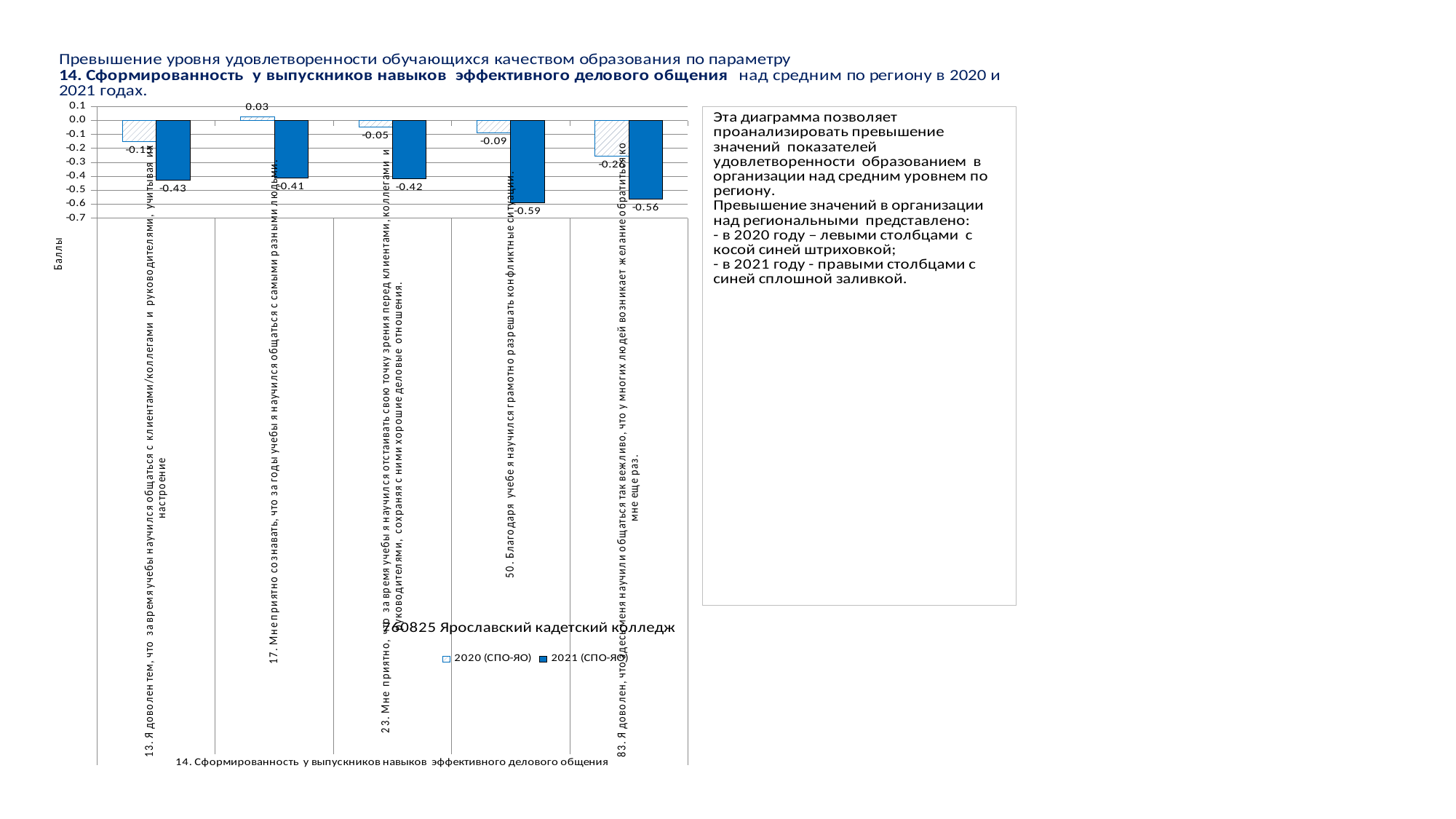
How many categories are shown on the x axis of the chart? 5 What is the 2020 (СПО-ЯО) value for category 23? -0.05 What is the 2021 (СПО-ЯО) value for category 13? -0.43 Which category has the highest 2020 (СПО-ЯО) value? 17 What is the 2020 (СПО-ЯО) value for category 17 (Мне приятно сознавать, что за годы учебы я научился общаться с самыми разными людьми)? 0.03 What kind of chart is shown on the slide? Bar chart Which category has the lowest 2021 (СПО-ЯО) value? 50 How many series does the legend list? 2 Which is larger: the 2020 (СПО-ЯО) value for category 17 or for category 50? Category 17 What is the difference between the 2021 (СПО-ЯО) values for category 17 and category 50? 0.18 Is the 2020 (СПО-ЯО) value for category 83 greater or less than -0.2? less What is the 2021 (СПО-ЯО) value for category 50 (Благодаря учебе я научился грамотно разрешать конфликтные ситуации)? -0.59